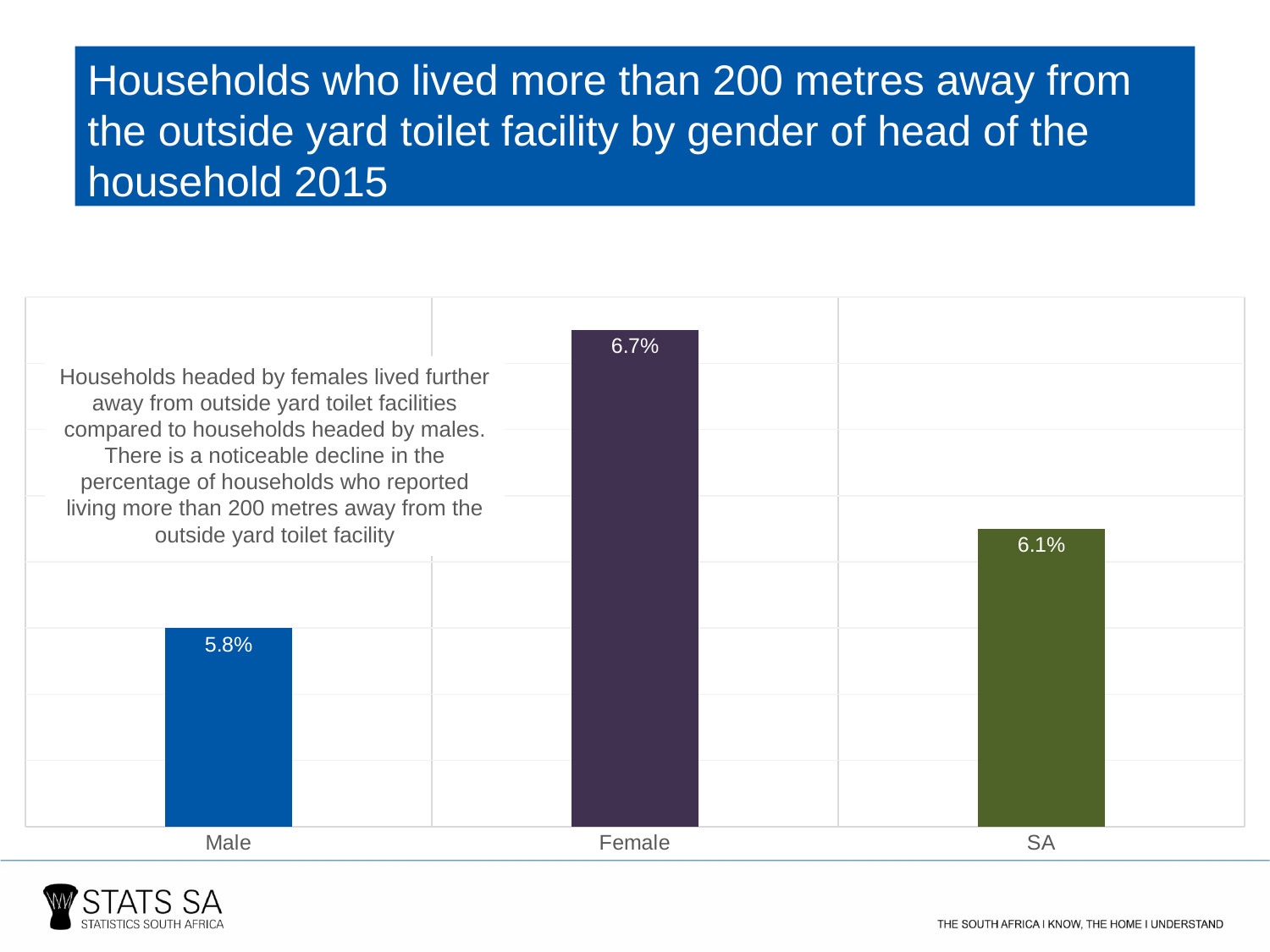
What is the value for Male? 5.8% Which category has the highest value? Female Which is larger, the value for Female or the value for SA? Female What colour is the bar for SA? Green How many categories are shown on the x axis? 3 What kind of chart is shown on the slide? Bar chart What is the value for Female? 6.7% What colour is the bar for Male? Blue Which category has the lowest value? Male What is the difference between the SA and Male values? 0.3% What is the value for SA? 6.1% What is the difference between the Female and Male values? 0.9%